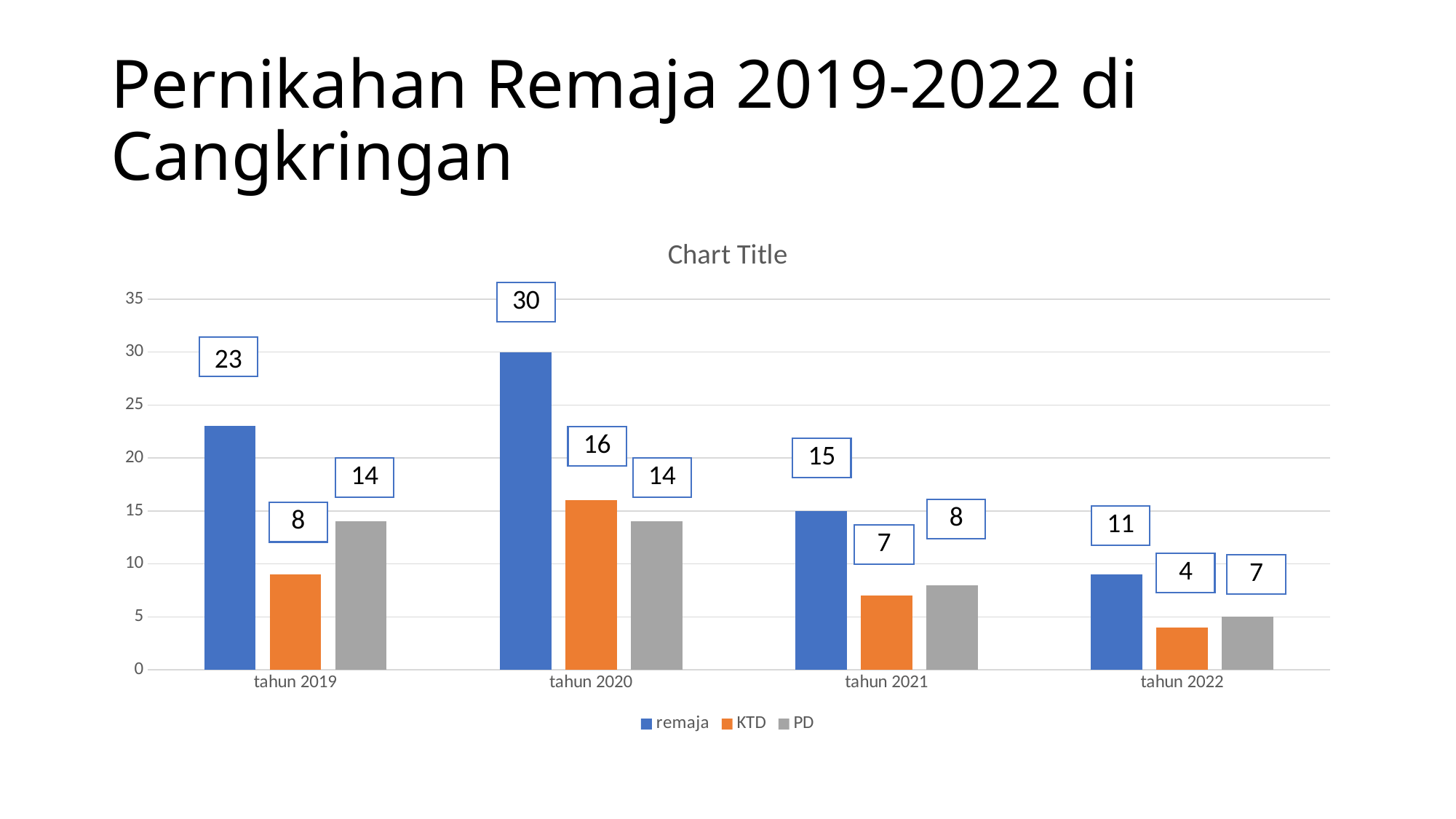
What kind of chart is shown on the slide? bar chart What is the value for remaja in tahun 2020? 30 Which is larger, the PD value in tahun 2020 or the PD value in tahun 2021? PD in tahun 2020 How many series does the legend list? 3 What is the value for PD in tahun 2019? 14 What is the value for KTD in tahun 2020? 16 What is the difference between the remaja value in tahun 2020 and the remaja value in tahun 2019? 7 How many year categories are shown on the x axis? 4 In which year is the KTD value lowest? tahun 2022 In which year is the remaja value highest? tahun 2020 What is the value for remaja in tahun 2021? 15 What is the value for KTD in tahun 2022? 4